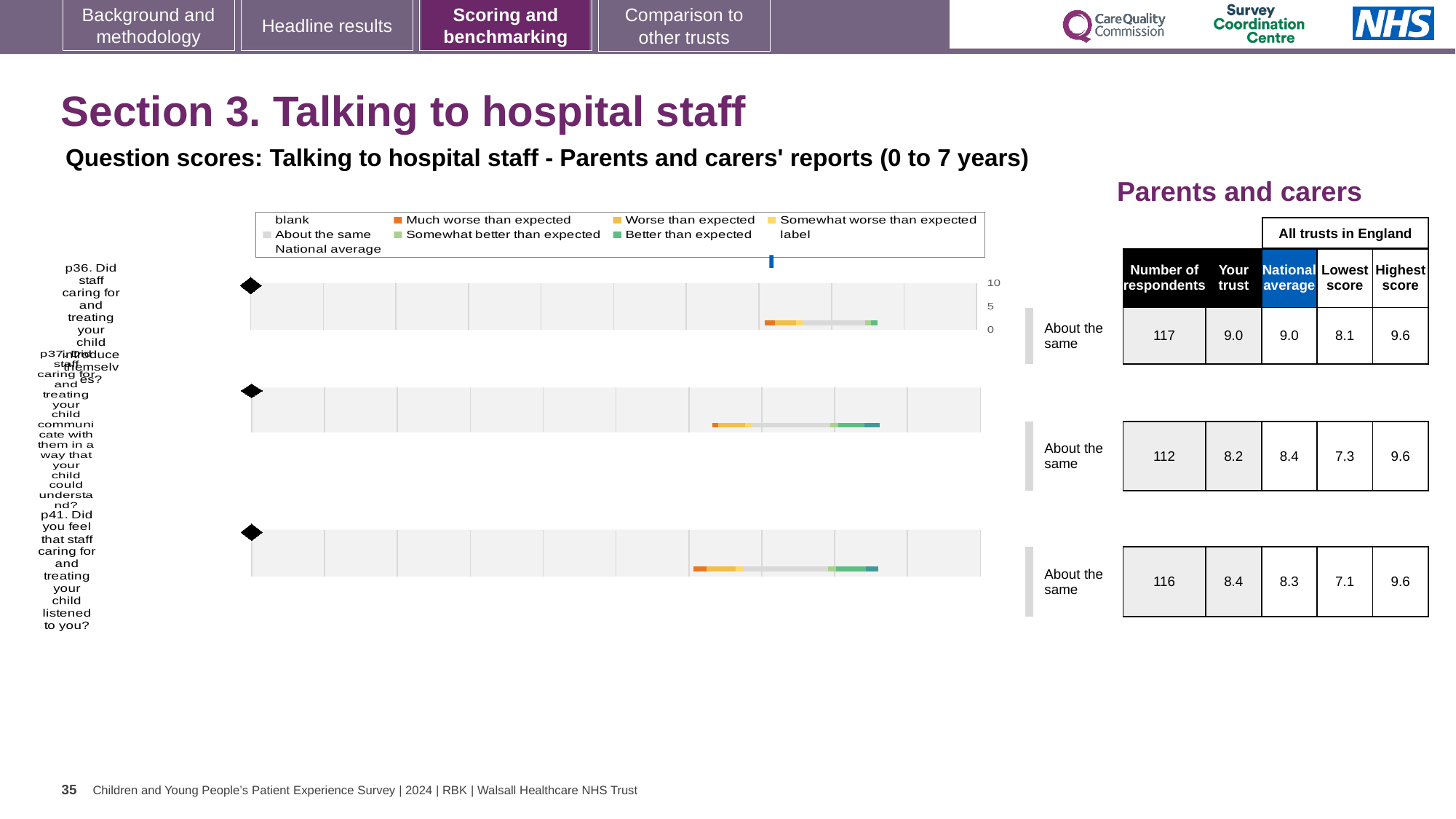
What is the highest tick value shown on the axis of the first chart (p36)? 10 For p37, what is the difference between the National average and the Your trust score? 0.2 What is the 'National average' score for p37 (Did staff communicate with them in a way that your child could understand)? 8.4 What is the 'Lowest score' for p41 (Did you feel that staff caring for and treating your child listened to you)? 7.1 How many entries does the legend above the charts list? 9 How many question charts (rows) are shown on the slide? 3 Which question has the lowest 'Lowest score' across all trusts in England? p41 Which question has the highest number of respondents? p36 How many respondents answered p37? 112 For p41, which is larger: the Your trust score or the National average? Your trust What is the 'Your trust' score for p36 (Did staff caring for and treating your child introduce themselves)? 9.0 What kind of chart is used for the three question rows on this slide? bar chart